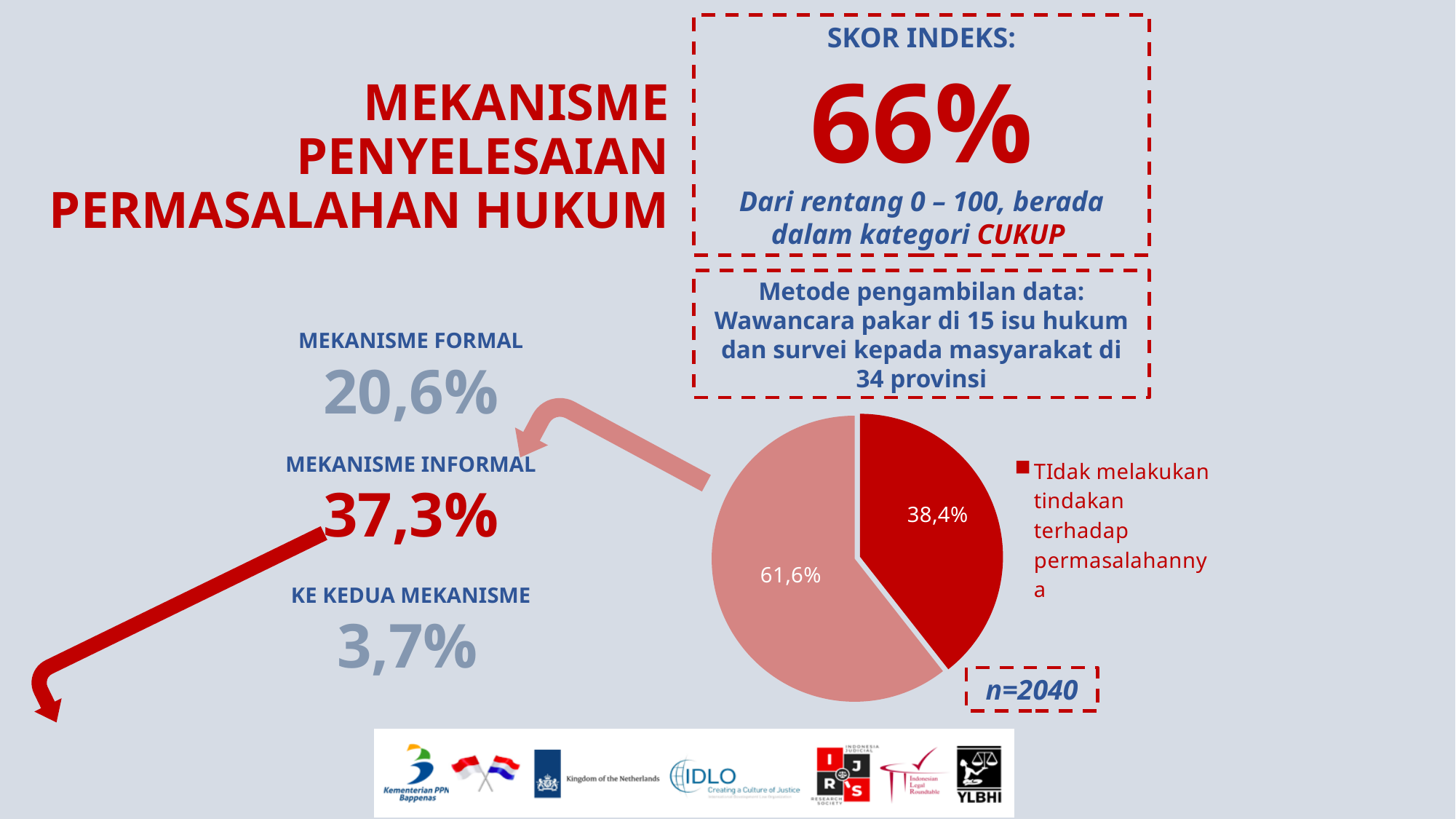
What is the value shown on the smaller slice of the pie chart? 38,4% What is the difference in percentage points between the two slices of the pie chart? 23,2 Which slice is larger: the one labelled 38,4% or the one labelled 61,6%? 61,6% How many entries does the legend of the pie chart list? 1 What is the total of the two slices shown in the pie chart? 100% Is the share for "TIdak melakukan tindakan terhadap permasalahannya" greater or less than 50%? less What colour is the slice labelled 38,4% in the pie chart? red What kind of chart is shown on the slide? pie chart What share of the pie is labelled "TIdak melakukan tindakan terhadap permasalahannya"? 38,4% What sample size (n) is shown next to the pie chart? n=2040 How many slices does the pie chart have? 2 What is the value shown on the larger slice of the pie chart? 61,6%